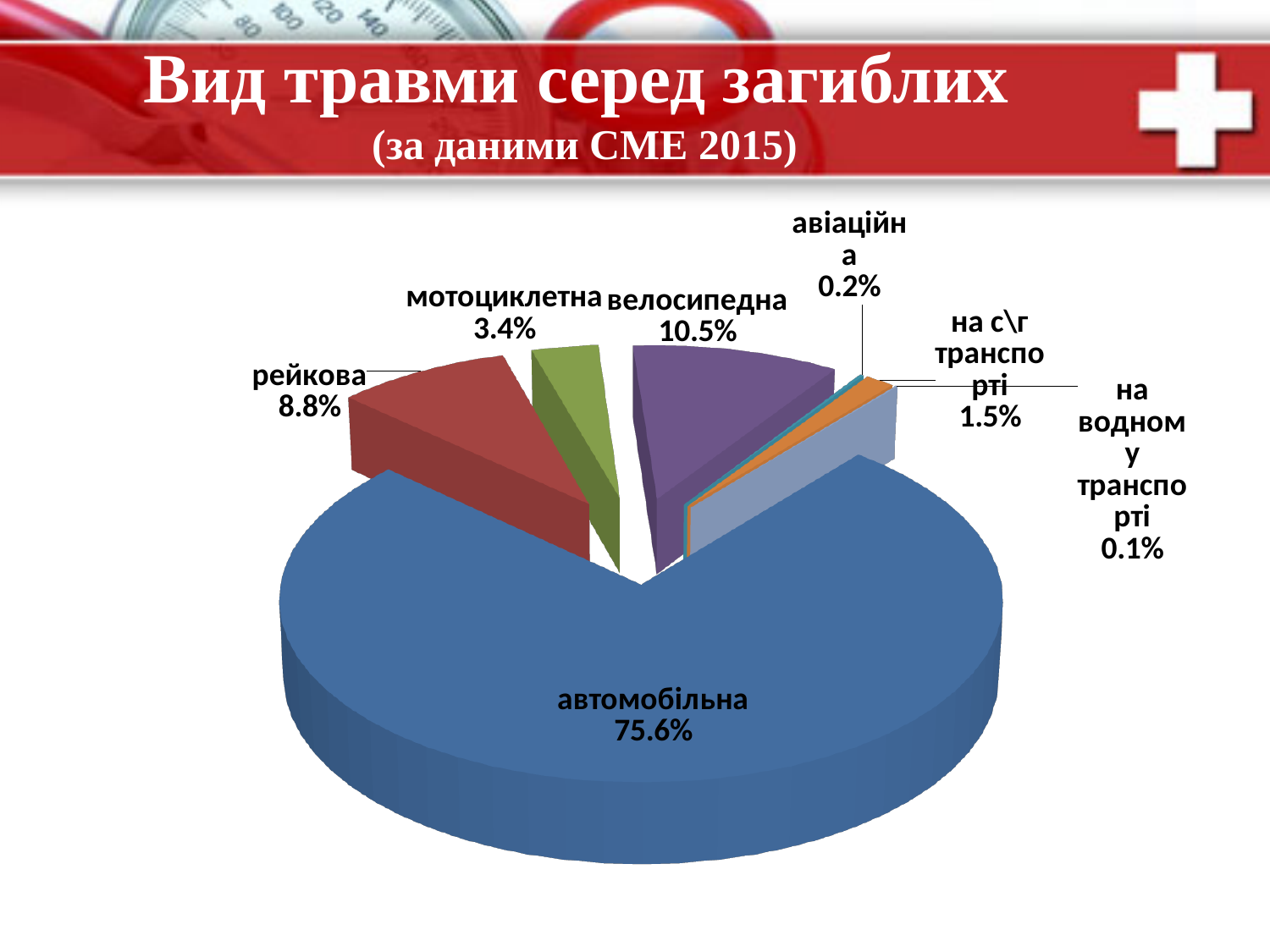
What share of the pie does автомобільна account for? 75.6% How many categories are shown in the pie chart? 7 Which is larger, the share for мотоциклетна or the share for рейкова? рейкова What is the difference between the shares of велосипедна and рейкова? 1.7% What is the value shown for мотоциклетна? 3.4% What kind of chart is shown on the slide? pie chart Which category has the largest slice of the pie? автомобільна Which category has the smallest slice of the pie? на водному транспорті What is the value shown for рейкова? 8.8% What is the title of the chart on the slide? Вид травми серед загиблих (за даними СМЕ 2015) What is the value shown for велосипедна? 10.5% What is the value shown for на с\г транспорті? 1.5%